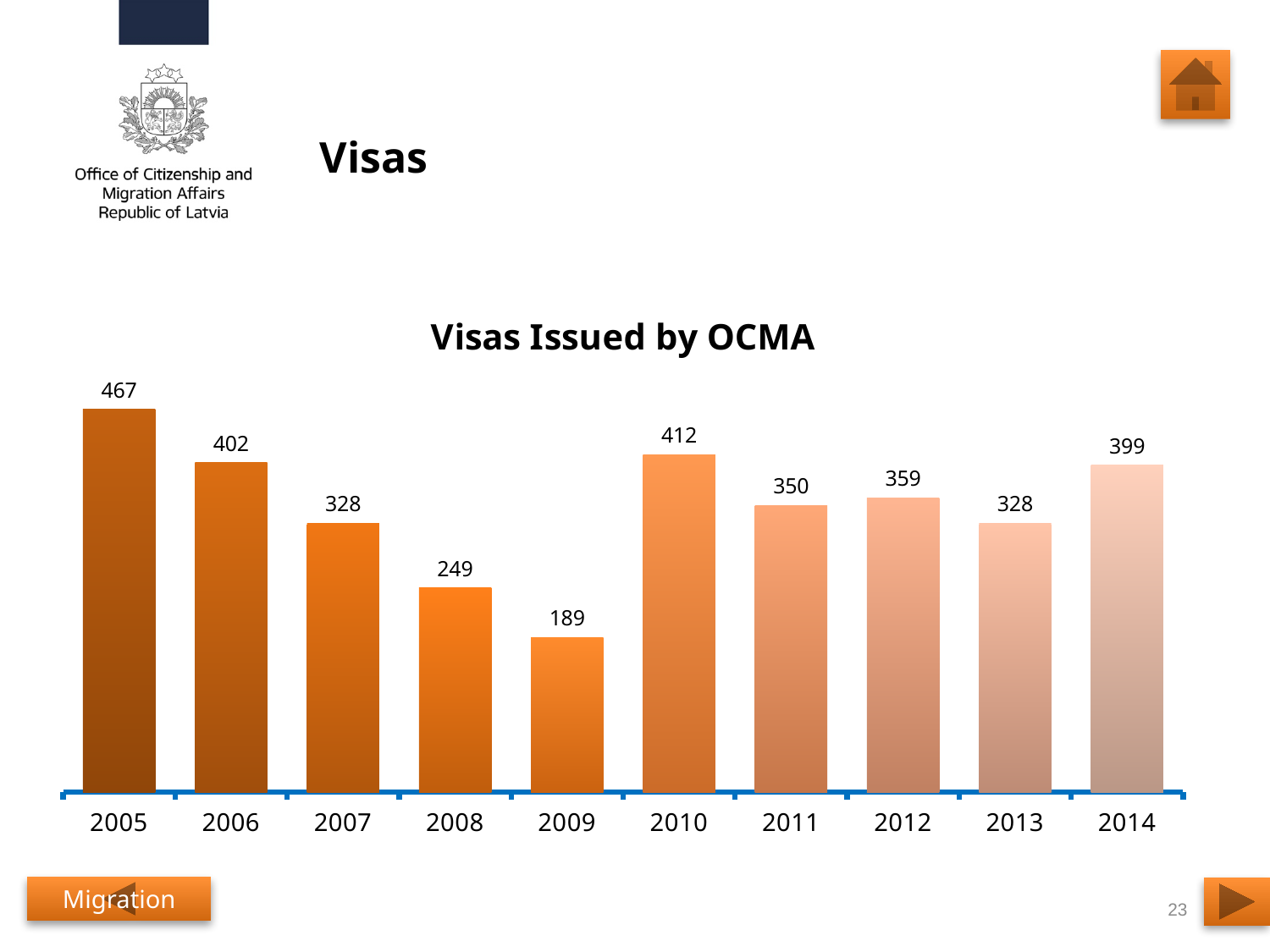
What is the difference between the values for 2005 and 2014? 68 What is the value shown for 2009 in the Visas Issued by OCMA chart? 189 What is the title of the chart on the slide? Visas Issued by OCMA How many visas were issued by OCMA in 2005? 467 Do the values rise or fall from 2005 to 2009? Fall What type of chart is used to show Visas Issued by OCMA? Bar chart Which year had more visas issued, 2011 or 2012? 2012 Which year has the highest number of visas issued by OCMA? 2005 How many years are shown on the x axis of the chart? 10 Which year has the lowest number of visas issued by OCMA? 2009 What is the value shown for 2014? 399 What is the difference between the visas issued in 2010 and in 2009? 223